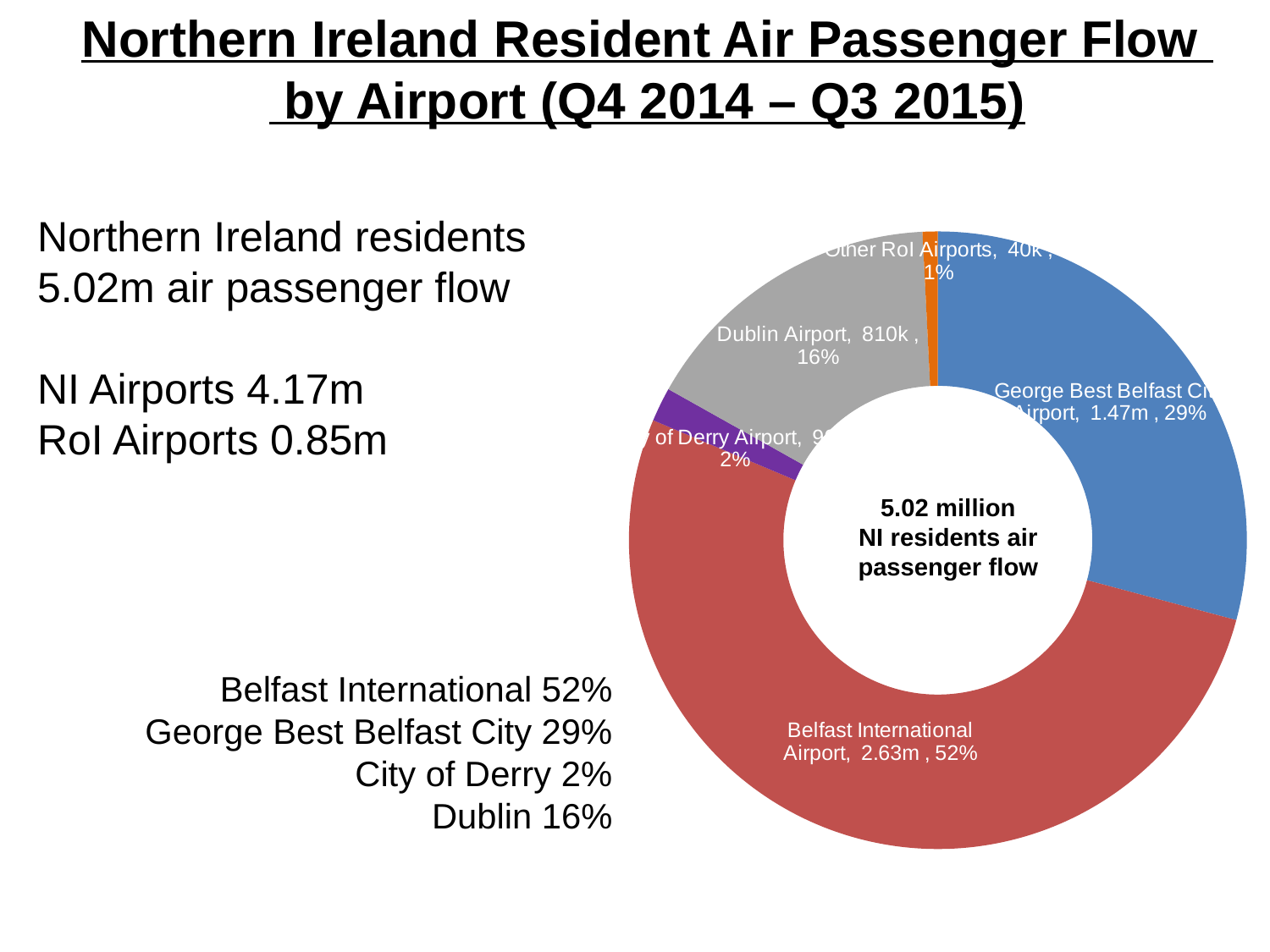
What share of the chart does Dublin Airport represent? 16% What is the passenger flow value shown for Belfast International Airport? 2.63m Which airport has the smallest share of the chart? Other RoI Airports What is the passenger flow value shown for Other RoI Airports? 40k What kind of chart is shown on the slide? Doughnut (pie) chart Which airport has the largest share of the chart? Belfast International Airport How many airport categories are shown in the chart? 5 What is the passenger flow value shown for Dublin Airport? 810k What share of the chart does City of Derry Airport represent? 2% What is the passenger flow value shown for George Best Belfast City Airport? 1.47m Which is larger, the share for George Best Belfast City Airport or the share for Dublin Airport? George Best Belfast City Airport What total is written in the centre of the doughnut chart? 5.02 million NI residents air passenger flow